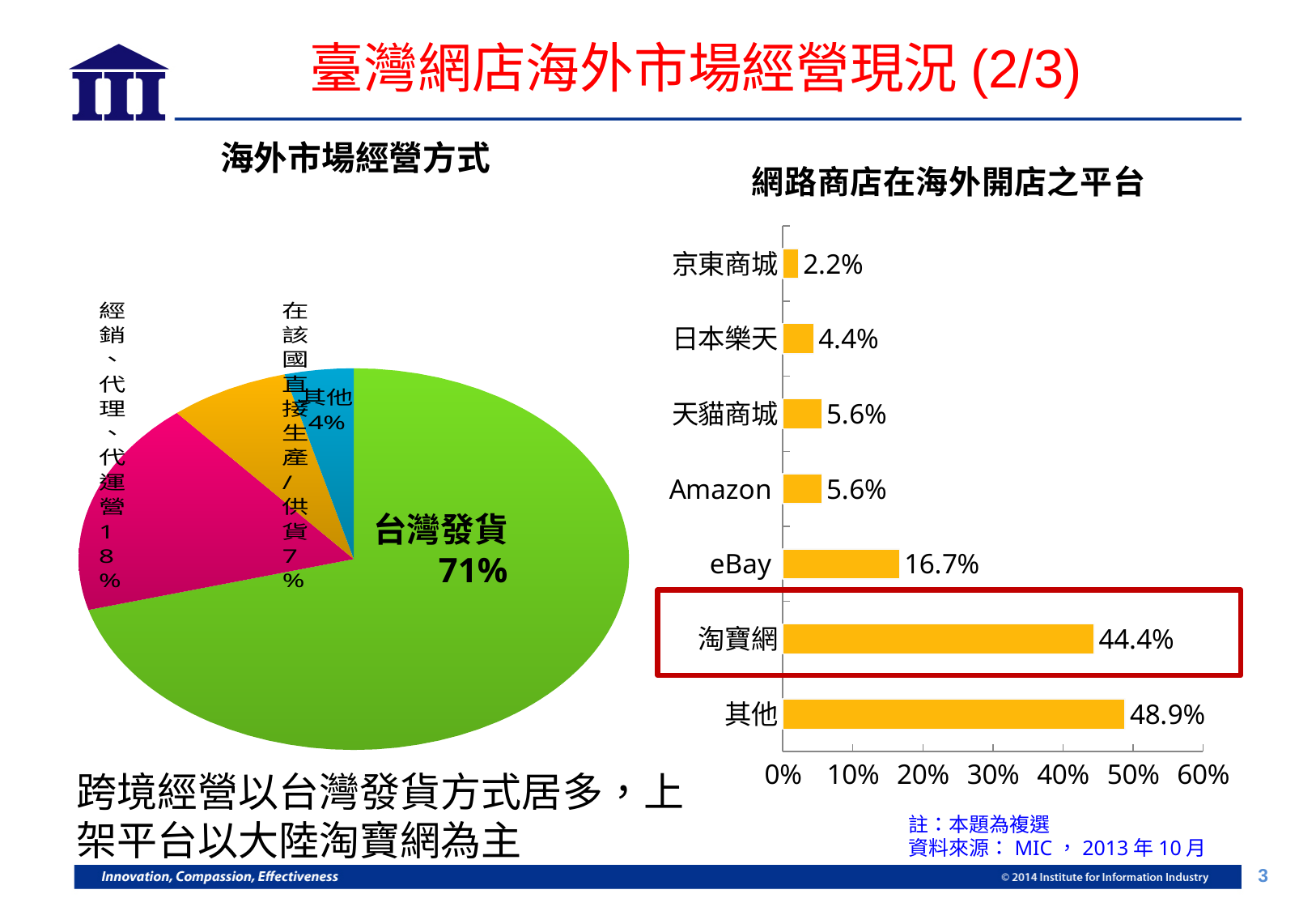
In the bar chart titled 網路商店在海外開店之平台, how many platforms are listed? 7 In the pie chart titled 海外市場經營方式, what share does 台灣發貨 have? 71% In the bar chart titled 網路商店在海外開店之平台, which is larger, the value for 日本樂天 or the value for 天貓商城? 天貓商城 In the pie chart titled 海外市場經營方式, which slice is the smallest? 其他 In the bar chart titled 網路商店在海外開店之平台, which platform has the lowest value? 京東商城 In the bar chart titled 網路商店在海外開店之平台, what is the value for eBay? 16.7% In the bar chart titled 網路商店在海外開店之平台, which category has the highest value? 其他 In the bar chart titled 網路商店在海外開店之平台, what is the value for 淘寶網? 44.4% What kind of chart is the chart titled 網路商店在海外開店之平台? Bar chart In the pie chart titled 海外市場經營方式, how many slices are there? 4 In the bar chart titled 網路商店在海外開店之平台, what is the difference between the values for 其他 and 淘寶網? 4.5% In the pie chart titled 海外市場經營方式, what share does 經銷、代理、代運營 have? 18%